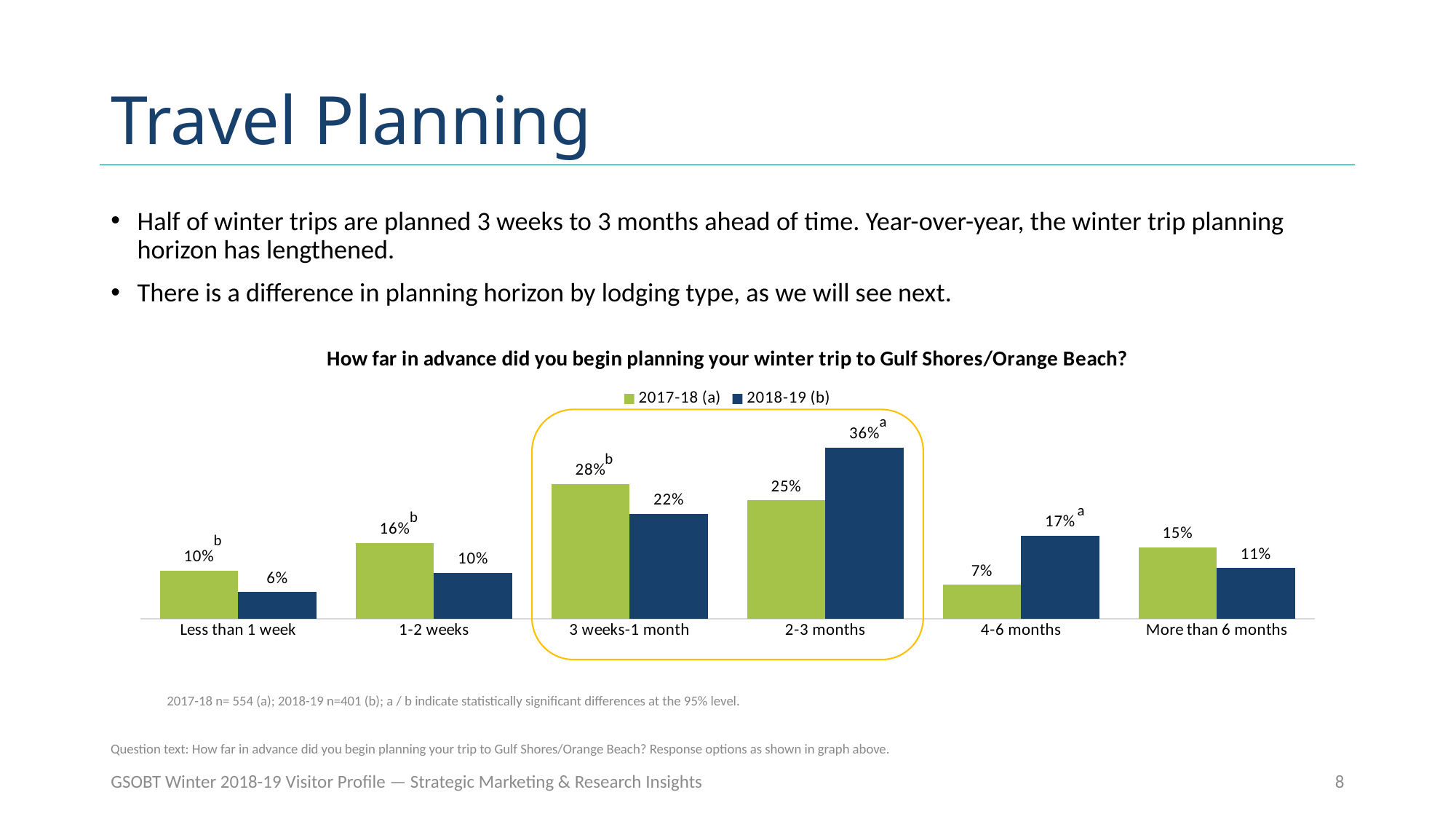
What is the difference between the 2018-19 (b) and 2017-18 (a) values in the 2-3 months category? 11% What kind of chart is shown on the slide? Bar chart What is the difference between the 2017-18 (a) and 2018-19 (b) values in the 1-2 weeks category? 6% What is the value for 2017-18 (a) in the 3 weeks-1 month category? 28% Which series has the larger value in the More than 6 months category, 2017-18 (a) or 2018-19 (b)? 2017-18 (a) How many series does the chart's legend list? 2 Which category has the highest value for the 2018-19 (b) series? 2-3 months What is the value for 2018-19 (b) in the 2-3 months category? 36% Which series has the larger value in the 4-6 months category, 2017-18 (a) or 2018-19 (b)? 2018-19 (b) Which category has the lowest value for the 2017-18 (a) series? 4-6 months How many categories are shown on the x axis of the chart? 6 What is the value for 2018-19 (b) in the Less than 1 week category? 6%